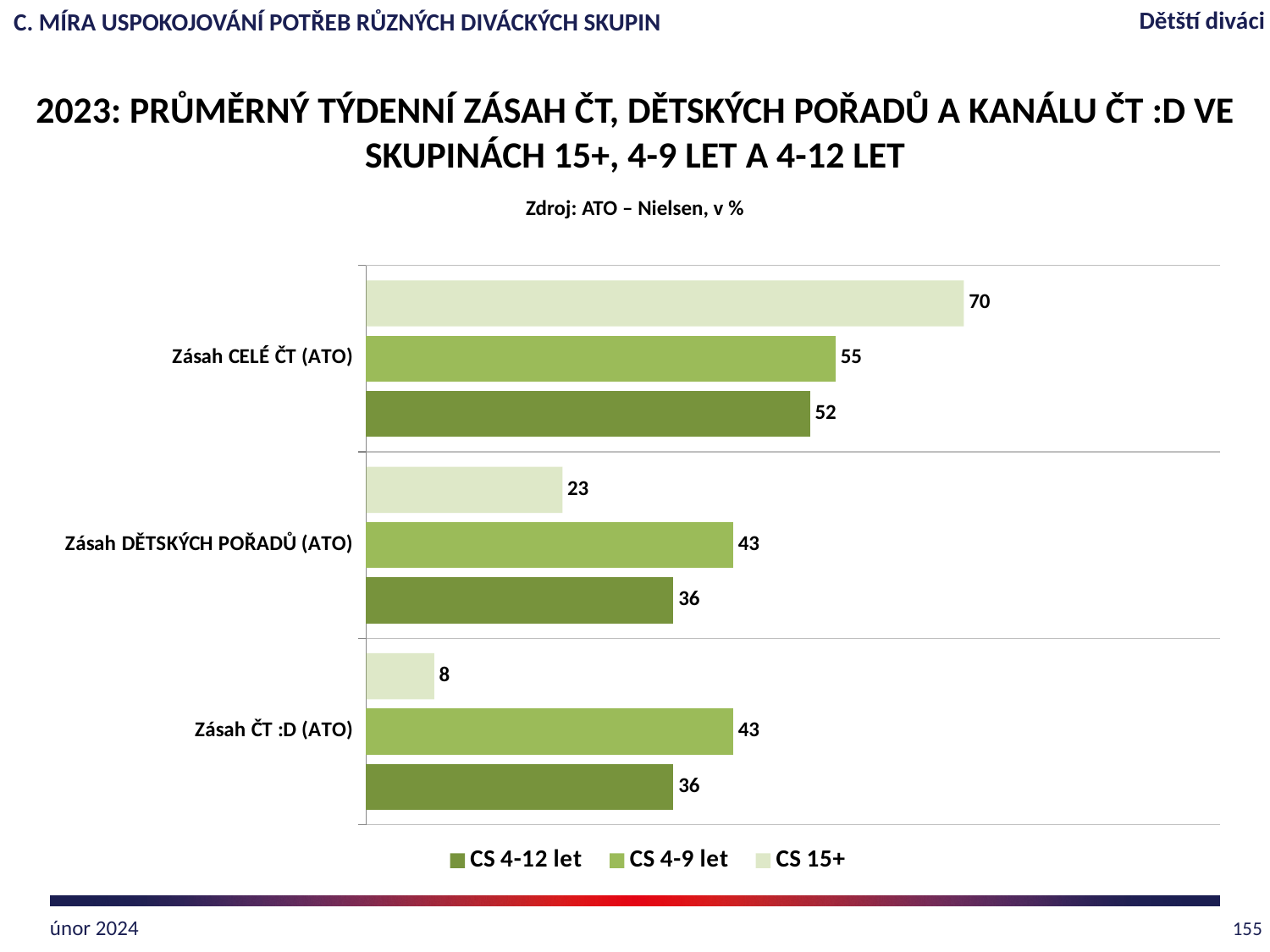
What is the value for CS 15+ in the Zásah CELÉ ČT (ATO) category? 70 What is the value for CS 15+ in the Zásah ČT :D (ATO) category? 8 In the Zásah DĚTSKÝCH POŘADŮ (ATO) category, which is larger: the value for CS 4-9 let or the value for CS 15+? CS 4-9 let What kind of chart is shown on the slide? Bar chart What is the difference between the CS 4-9 let value and the CS 15+ value in the Zásah DĚTSKÝCH POŘADŮ (ATO) category? 20 What is the difference between the CS 15+ value and the CS 4-12 let value in the Zásah CELÉ ČT (ATO) category? 18 Which category has the highest value for CS 15+? Zásah CELÉ ČT (ATO) How many series does the legend list? 3 How many categories are shown on the chart? 3 What is the value for CS 4-12 let in the Zásah ČT :D (ATO) category? 36 What is the value for CS 4-9 let in the Zásah DĚTSKÝCH POŘADŮ (ATO) category? 43 Which category has the lowest value for CS 15+? Zásah ČT :D (ATO)